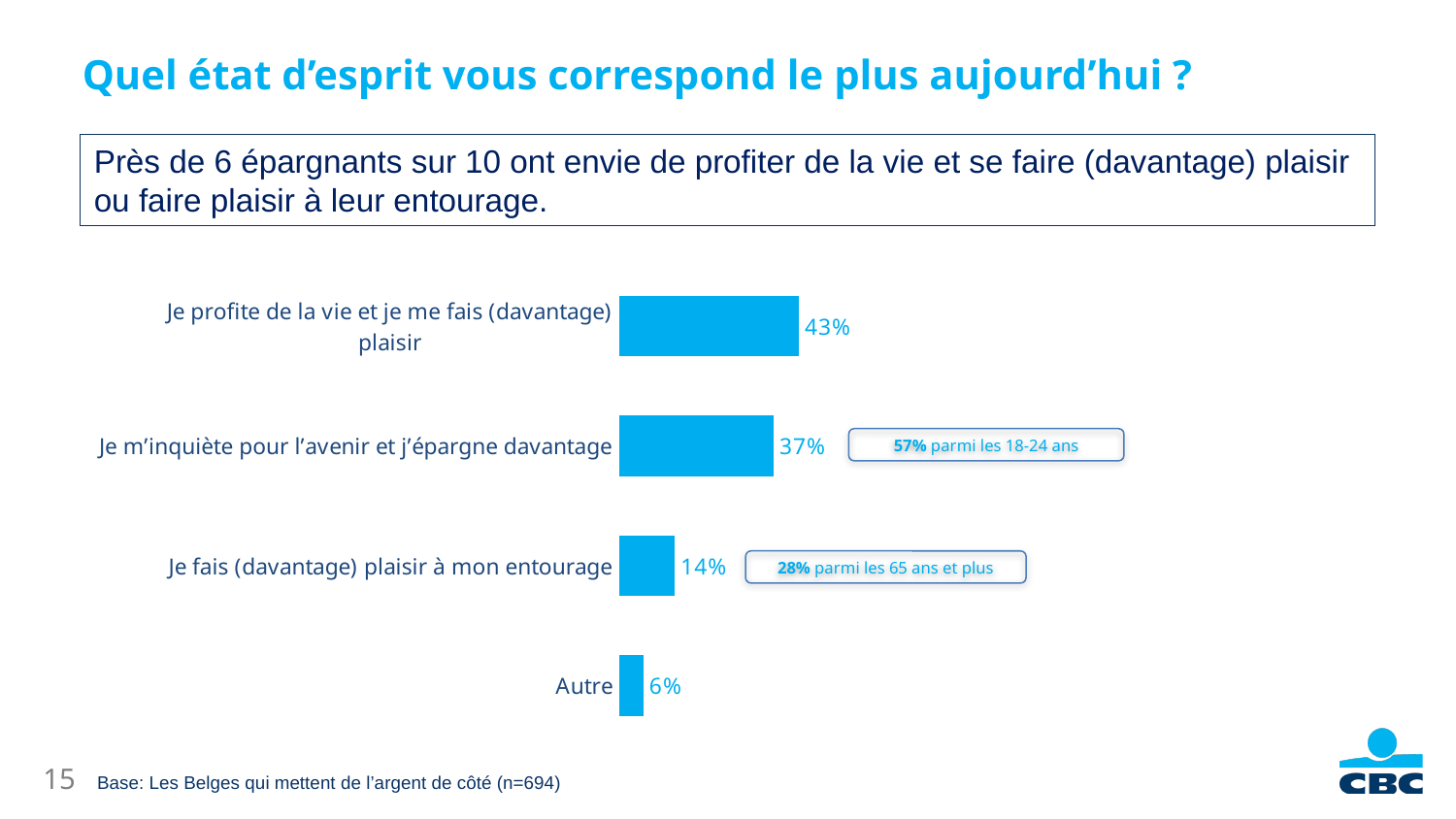
According to the callout next to the bar, what percentage of 18-24 year olds say "Je m'inquiète pour l'avenir et j'épargne davantage"? 57% Which category has the lowest value? Autre Which category has the highest value? Je profite de la vie et je me fais (davantage) plaisir What percentage is shown for "Je fais (davantage) plaisir à mon entourage"? 14% Which is larger: the value for "Je m'inquiète pour l'avenir et j'épargne davantage" or for "Je fais (davantage) plaisir à mon entourage"? Je m'inquiète pour l'avenir et j'épargne davantage What percentage is shown for "Autre"? 6% What is the difference between the values for "Je fais (davantage) plaisir à mon entourage" and "Autre"? 8% How many categories are shown in the chart? 4 What kind of chart is shown on the slide? Bar chart What percentage is shown for "Je m'inquiète pour l'avenir et j'épargne davantage"? 37% What percentage is shown for "Je profite de la vie et je me fais (davantage) plaisir"? 43% What is the difference between the values for "Je profite de la vie et je me fais (davantage) plaisir" and "Je m'inquiète pour l'avenir et j'épargne davantage"? 6%